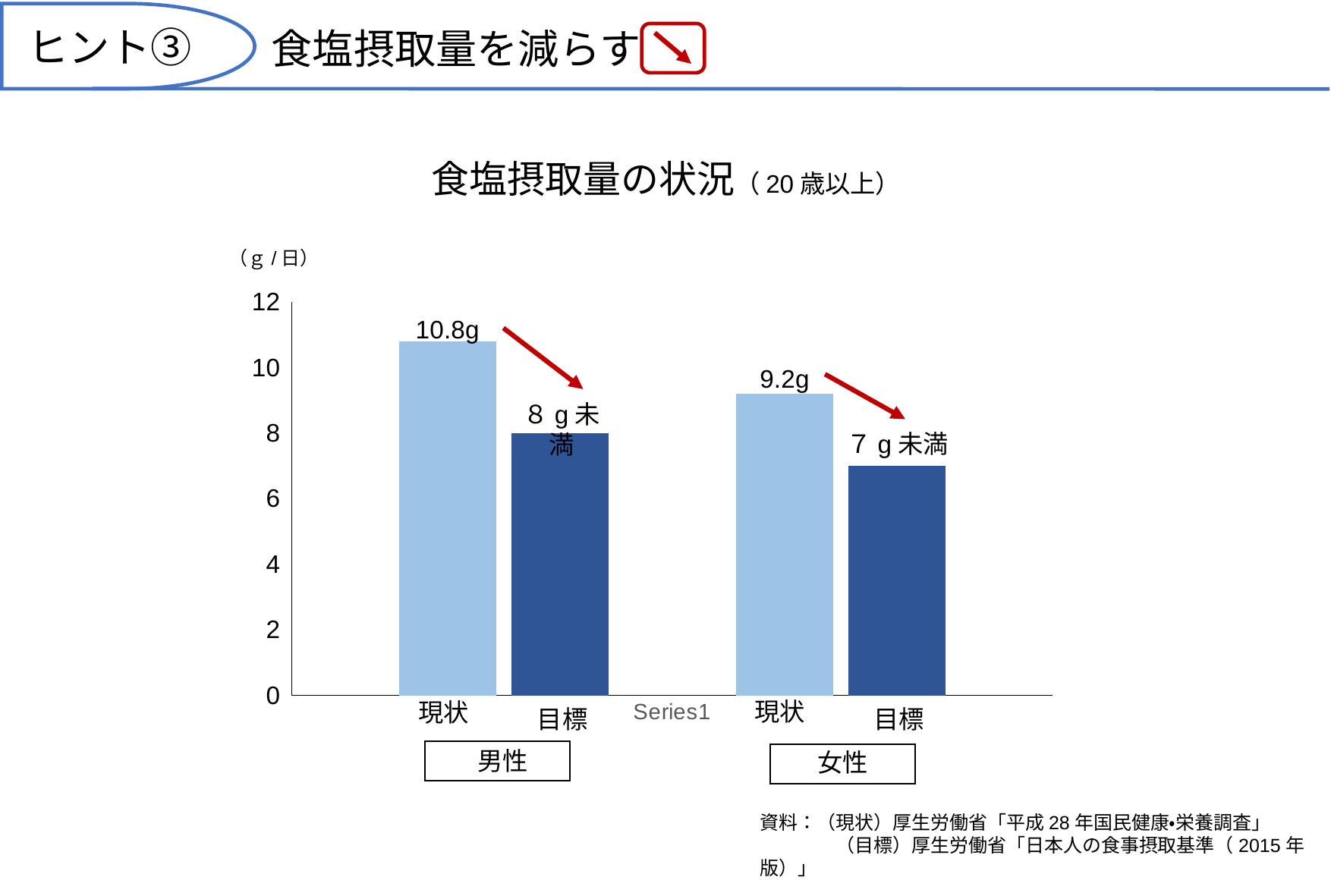
What is the current (現状) salt intake value shown for men (男性)? 10.8g How many bars are plotted in the chart? 4 Which bar is the highest in the chart? 男性 現状 (10.8g) What is the current (現状) salt intake value shown for women (女性)? 9.2g What kind of chart is shown on the slide? Bar chart Which is larger, the current (現状) salt intake for men or for women? Men (男性) Which bar is the lowest in the chart? 女性 目標 (7ｇ未満) What is the difference between the current salt intake of men (10.8g) and women (9.2g)? 1.6g What target (目標) value is labelled on the bar for women (女性)? 7ｇ未満 Is the current (現状) value for women greater or less than 10? less What unit is shown on the vertical axis of the chart? g/日 What target (目標) value is labelled on the bar for men (男性)? 8ｇ未満